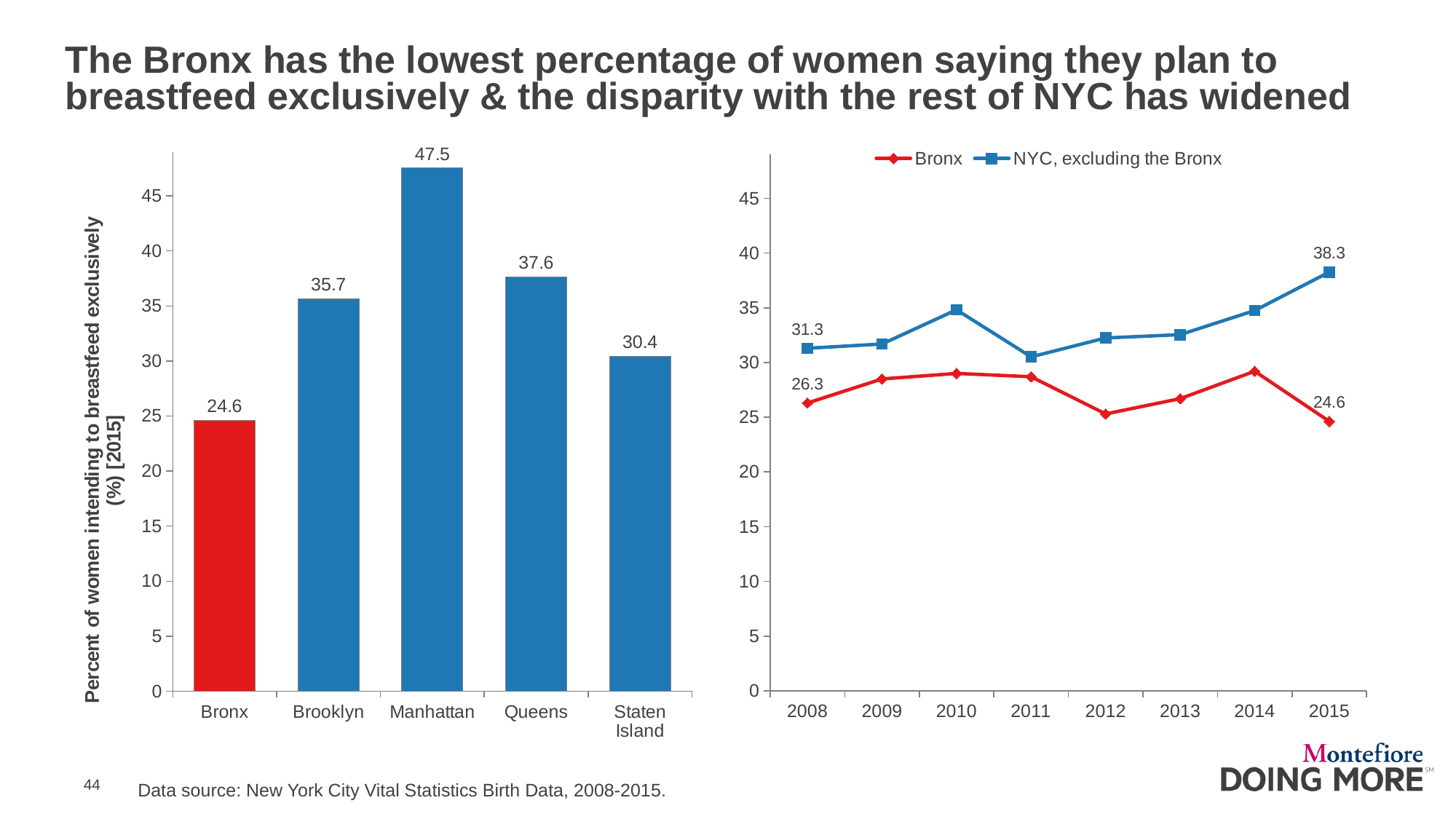
In the bar chart on the left, which borough has the highest value? Manhattan In the line chart on the right, what is the difference between the NYC, excluding the Bronx value and the Bronx value in 2015? 13.7 In the bar chart on the left, which borough has the lowest value? Bronx In the bar chart on the left, what is the difference between the values for Queens and Brooklyn? 1.9 What kind of chart is shown on the left side of the slide? Bar chart In the bar chart on the left, which is larger, the value for Staten Island or the value for Brooklyn? Brooklyn In the line chart on the right, how many series does the legend list? 2 In the line chart on the right, what is the value for NYC, excluding the Bronx in 2015? 38.3 In the bar chart on the left, how many boroughs are shown? 5 In the line chart on the right, is the value for Bronx in 2012 greater or less than 30? less In the line chart on the right, what is the value for Bronx in 2008? 26.3 In the bar chart on the left, what is the value for Manhattan? 47.5